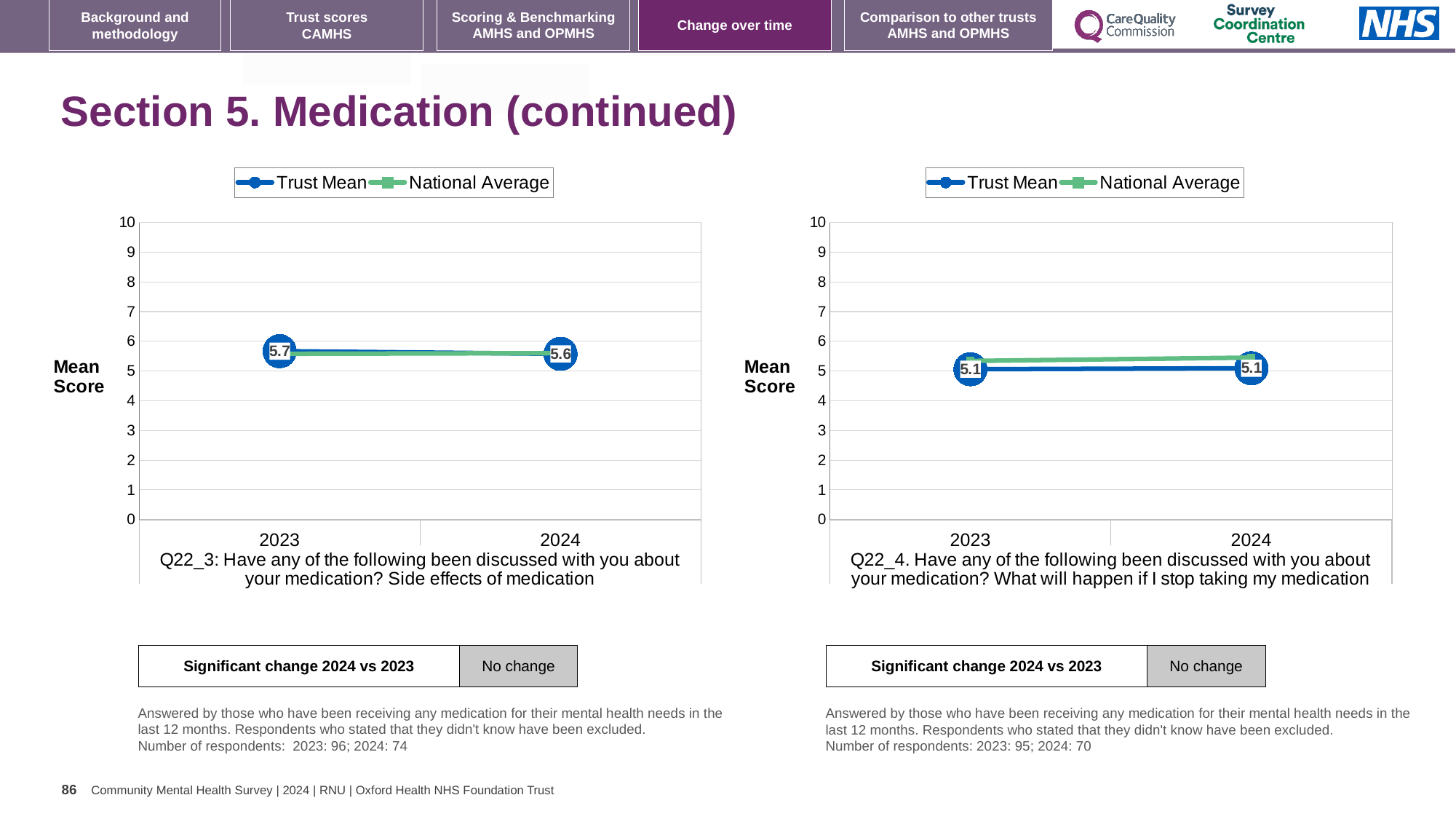
In the right chart (Q22_4), is the National Average for 2024 greater or less than 5? greater In the left chart (Q22_3), what is the Trust Mean for 2023? 5.7 What kind of chart is the left chart (Q22_3)? line chart In the left chart (Q22_3), by how much did the Trust Mean change from 2023 to 2024? 0.1 How many series does the legend of the right chart (Q22_4) list? 2 In the right chart (Q22_4), which is higher in 2023: the Trust Mean or the National Average? National Average How many years are shown on the x axis of the right chart (Q22_4)? 2 In the right chart (Q22_4), what is the Trust Mean for 2023? 5.1 In the left chart (Q22_3), does the Trust Mean rise or fall from 2023 to 2024? fall In the left chart (Q22_3), what is the Trust Mean for 2024? 5.6 In the right chart (Q22_4), what is the Trust Mean for 2024? 5.1 What are the two series named in the legend of the left chart (Q22_3)? Trust Mean and National Average